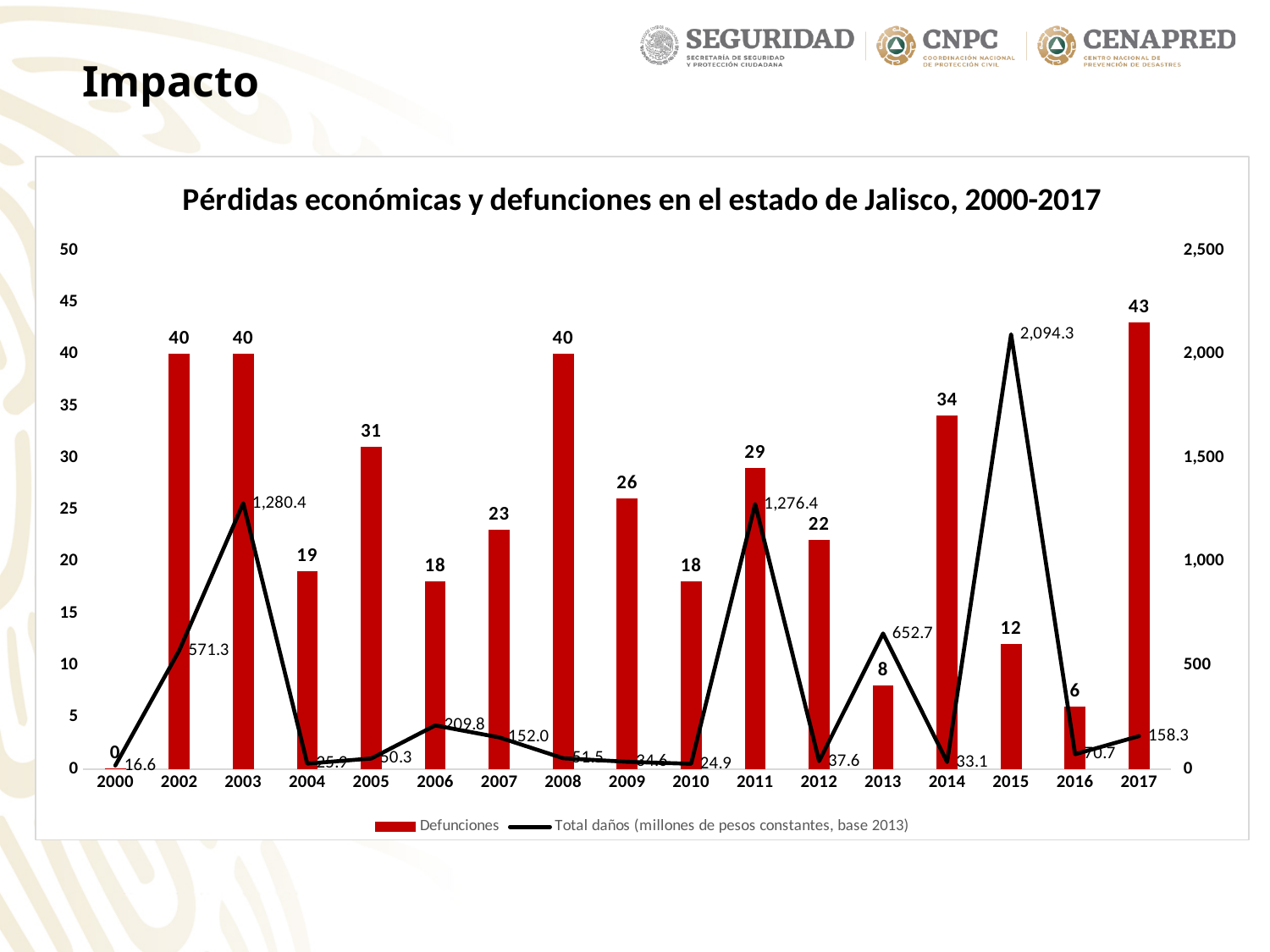
What is the Total daños value for 2003? 1,280.4 What is the difference in Defunciones between 2017 and 2014? 9 What is the Total daños value for 2015? 2,094.3 What is the number of Defunciones for 2017? 43 What is the Total daños value for 2013? 652.7 How many series does the legend list? 2 Which year has the lowest number of Defunciones? 2000 Which year has more Defunciones, 2005 or 2011? 2005 Which year has the highest Total daños value? 2015 What is the title of the chart? Pérdidas económicas y defunciones en el estado de Jalisco, 2000-2017 How many years are shown on the x axis? 17 Which year has the highest number of Defunciones? 2017